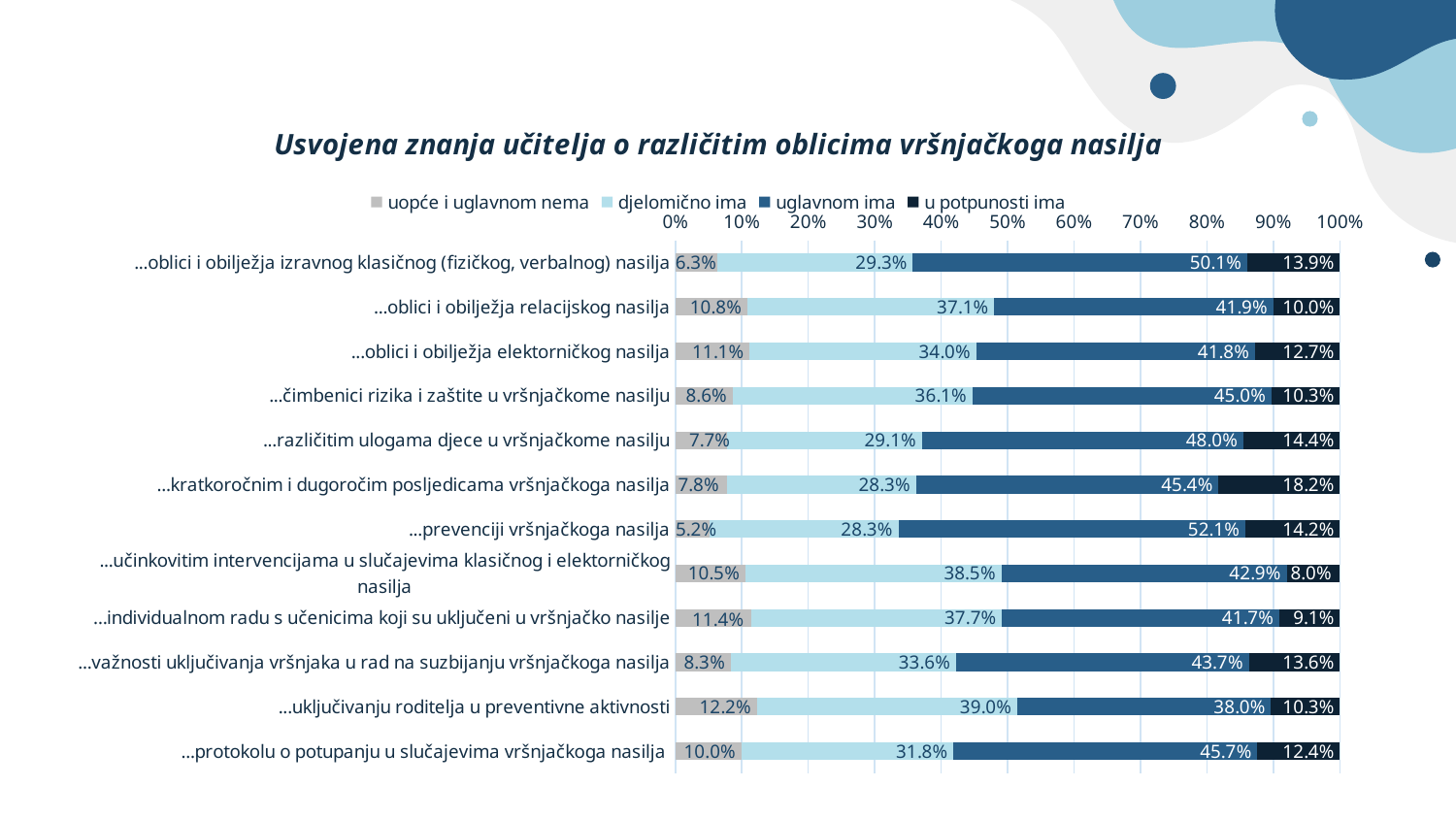
Which category has the lowest 'uopće i uglavnom nema' value? ...prevenciji vršnjačkoga nasilja Which is larger for '...uključivanju roditelja u preventivne aktivnosti': the 'djelomično ima' value or the 'uglavnom ima' value? djelomično ima What is the 'djelomično ima' value for '...oblici i obilježja relacijskog nasilja'? 37.1% What is the difference between the 'uglavnom ima' and 'u potpunosti ima' values for '...oblici i obilježja izravnog klasičnog (fizičkog, verbalnog) nasilja'? 36.2% What is the 'u potpunosti ima' value for '...kratkoročnim i dugoročim posljedicama vršnjačkoga nasilja'? 18.2% What is the title of the chart? Usvojena znanja učitelja o različitim oblicima vršnjačkoga nasilja Which category has the highest 'u potpunosti ima' value? ...kratkoročnim i dugoročim posljedicama vršnjačkoga nasilja How many categories (bars) are shown in the chart? 12 What type of chart is shown on the slide? Stacked bar chart How many series does the legend list? 4 What is the 'uopće i uglavnom nema' value for '...uključivanju roditelja u preventivne aktivnosti'? 12.2% What is the 'uglavnom ima' value for '...prevenciji vršnjačkoga nasilja'? 52.1%